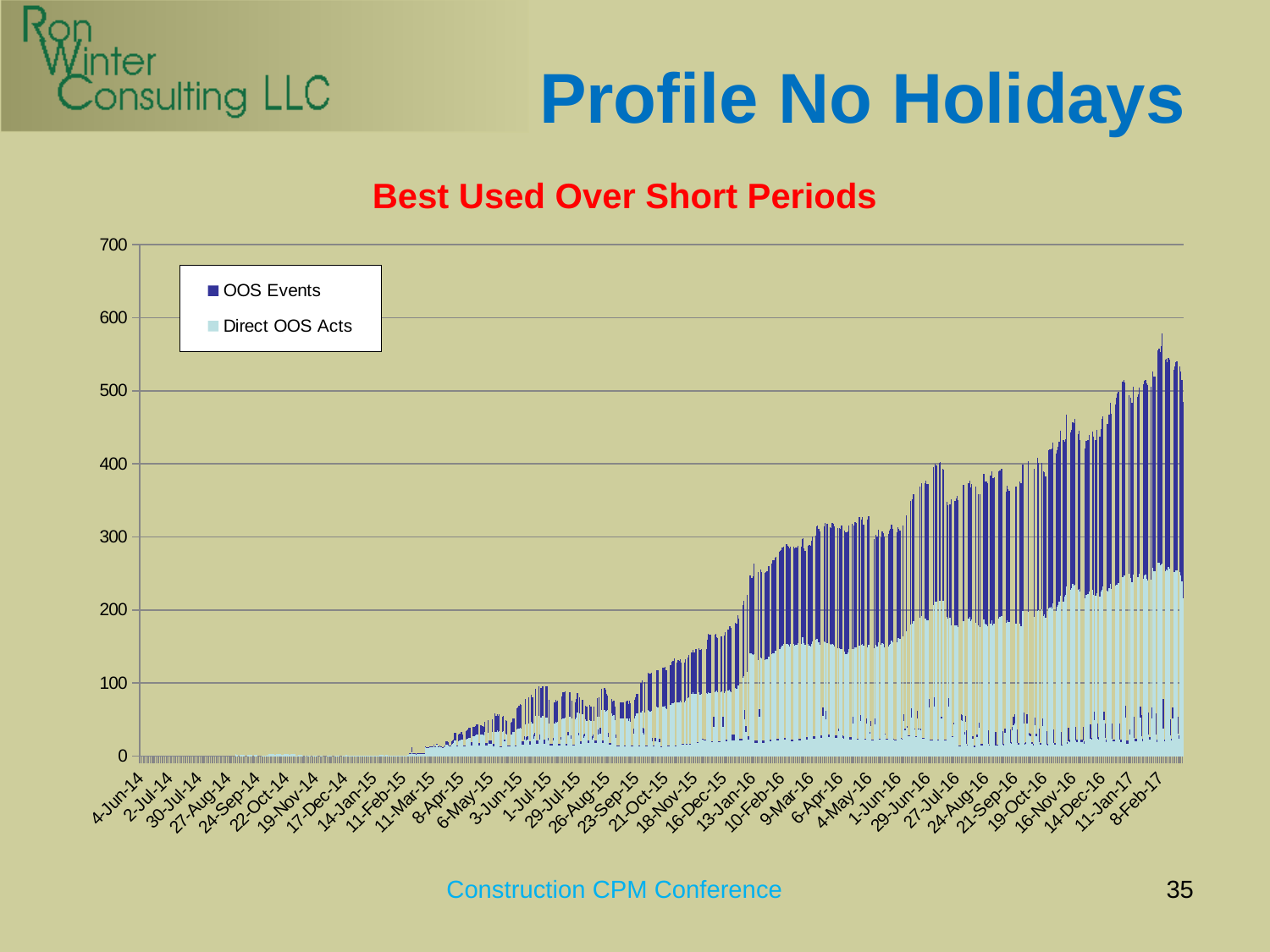
Do the tallest stacked bars appear at the left end or the right end of the chart? Right end Do the stacked bar totals generally rise or fall from left to right along the x axis? Rise Is the stacked total for the bars around 13-Jan-16 greater or less than 300? less Is the stacked total for the bars around 16-Dec-15 greater or less than 100? greater How many series does the legend list? 2 What is the highest value shown on the y axis? 700 Is the stacked total for the bars around 8-Feb-17 greater or less than 500? greater What kind of chart is shown on the slide? Stacked bar chart Which series is drawn in dark blue? OOS Events What are the two series named in the legend? OOS Events and Direct OOS Acts